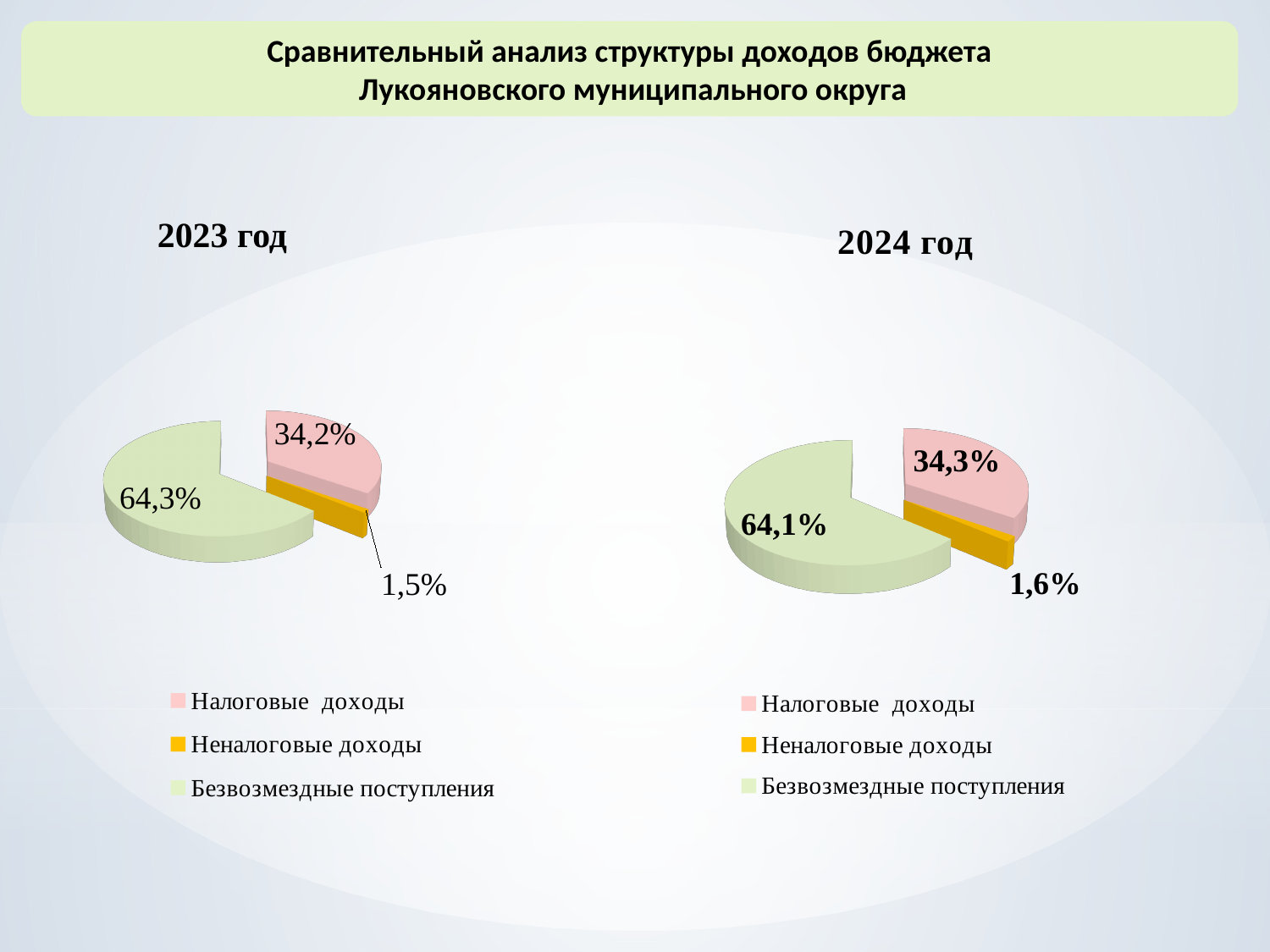
In the 2023 год chart, what is the value for Неналоговые доходы? 1,5% In the 2024 год chart, what is the difference between Безвозмездные поступления and Налоговые доходы? 29,8% How many slices does the 2023 год pie chart have? 3 In the 2023 год chart, which category has the largest share? Безвозмездные поступления How many entries does the legend of the 2024 год chart list? 3 In the 2024 год chart, which category has the smallest share? Неналоговые доходы Which is larger: Налоговые доходы in 2023 год or Налоговые доходы in 2024 год? 2024 год In the 2024 год chart, what share do Безвозмездные поступления have? 64,1% In the 2023 год chart, what colour represents Неналоговые доходы? Orange In the 2023 год chart, what share do Налоговые доходы have? 34,2% In the 2024 год chart, what is the value for Неналоговые доходы? 1,6% What type of chart is used for 2023 год? Pie chart